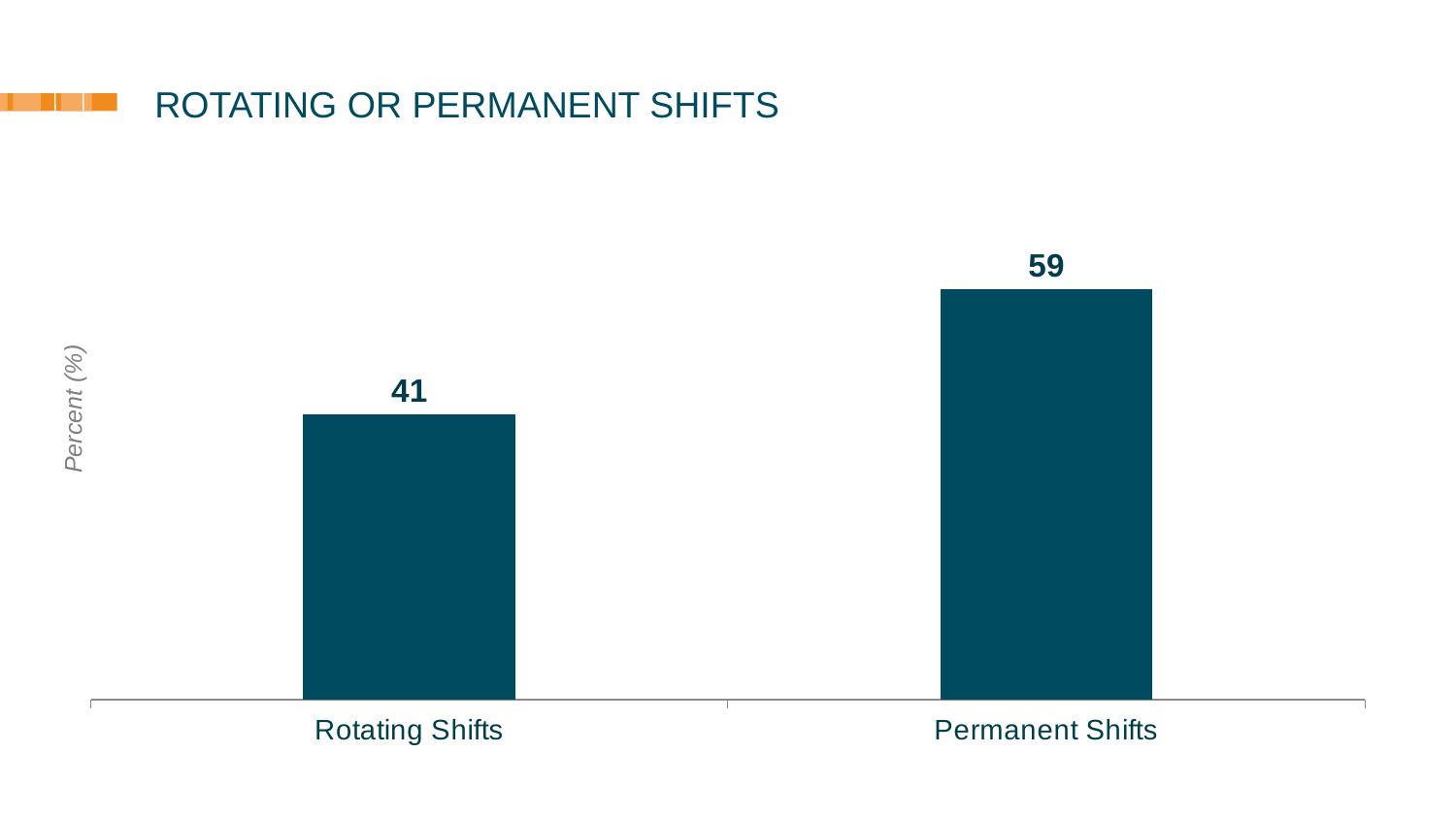
What is the value for Permanent Shifts? 59 Which category has the lowest value? Rotating Shifts What is the value for Rotating Shifts? 41 What kind of chart is shown on the slide? Bar chart What is the difference between the values for Permanent Shifts and Rotating Shifts? 18 Which is larger, the value for Rotating Shifts or the value for Permanent Shifts? Permanent Shifts What is the total of the two values shown in the chart? 100 What is the title of the slide? ROTATING OR PERMANENT SHIFTS Which category has the highest value? Permanent Shifts What is the label on the vertical axis? Percent (%) How many categories are shown in the chart? 2